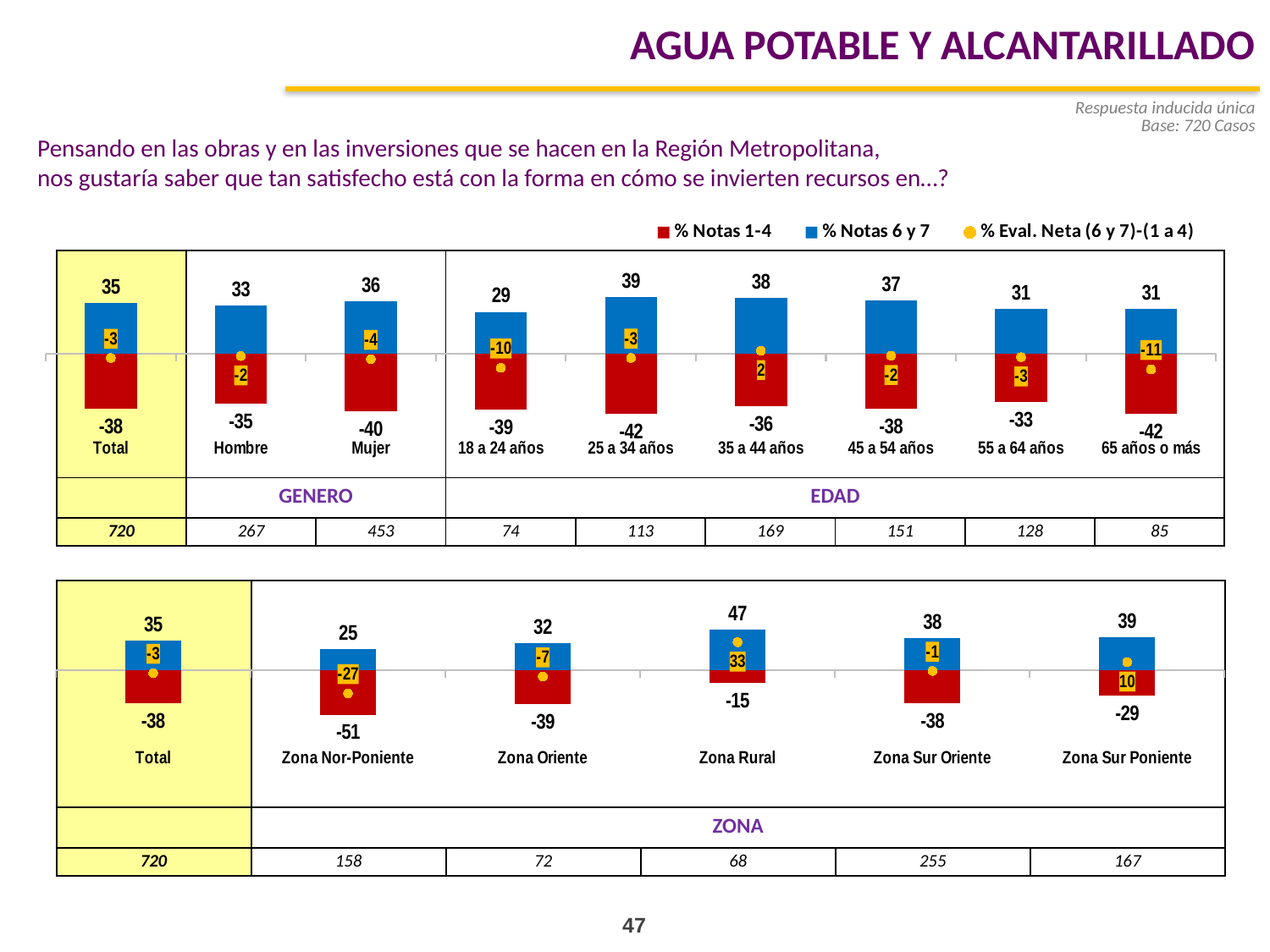
In the bottom chart, which zone has the highest % Eval. Neta value? Zona Rural In the bottom chart, what is the % Notas 1-4 value for Zona Nor-Poniente? -51 In the bottom chart, what is the % Notas 6 y 7 value for Zona Rural? 47 In the top chart, what is the % Notas 6 y 7 value for Mujer? 36 In the top chart, what is the % Notas 1-4 value for 25 a 34 años? -42 In the bottom chart, which is larger, the % Notas 6 y 7 value for Zona Sur Poniente or for Zona Oriente? Zona Sur Poniente How many zones are shown in the bottom chart, excluding Total? 5 In the top chart, which age group has the lowest % Notas 6 y 7 value? 18 a 24 años How many series does the legend list? 3 In the top chart, which age group has the highest % Notas 6 y 7 value? 25 a 34 años In the top chart, what is the difference between the % Notas 6 y 7 values for Mujer and Hombre? 3 In the top chart, what is the % Eval. Neta value for 65 años o más? -11